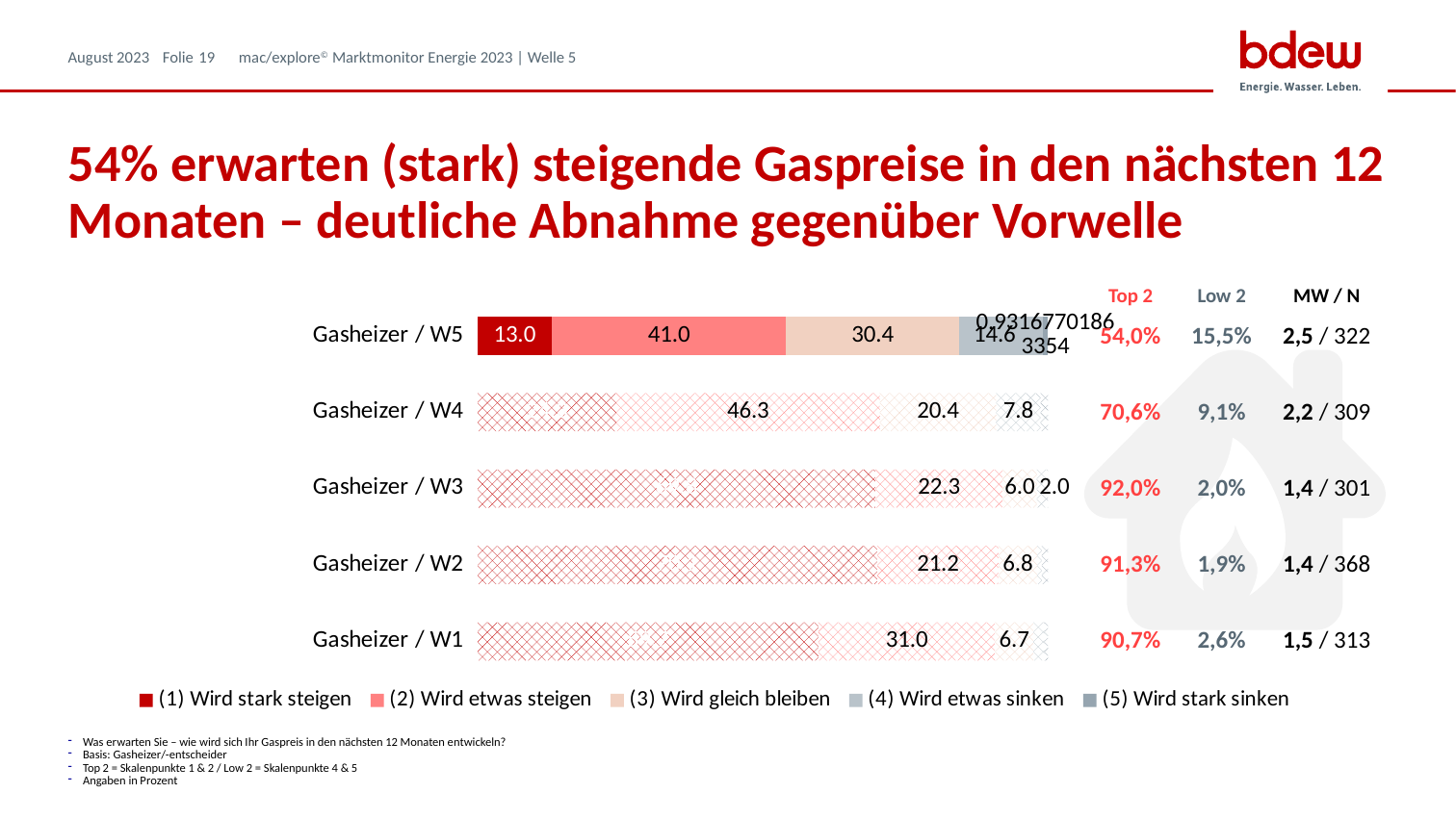
What is the value for "(2) Wird etwas steigen" for Gasheizer / W4? 46.3 How many categories (waves) are shown on the chart? 5 How many series does the legend list? 5 What is the value for "(2) Wird etwas steigen" for Gasheizer / W5? 41.0 What is the difference between the "(3) Wird gleich bleiben" values for Gasheizer / W5 and Gasheizer / W4? 10.0 What is the value for "(4) Wird etwas sinken" for Gasheizer / W3? 2.0 What is the value for "(3) Wird gleich bleiben" for Gasheizer / W5? 30.4 What is the value for "(3) Wird gleich bleiben" for Gasheizer / W1? 6.7 Which is larger: the "(3) Wird gleich bleiben" value for Gasheizer / W5 or for Gasheizer / W4? Gasheizer / W5 What is the Top 2 value shown for Gasheizer / W3? 92,0% What is the value for "(1) Wird stark steigen" for Gasheizer / W5? 13.0 What kind of chart is shown on the slide? stacked bar chart